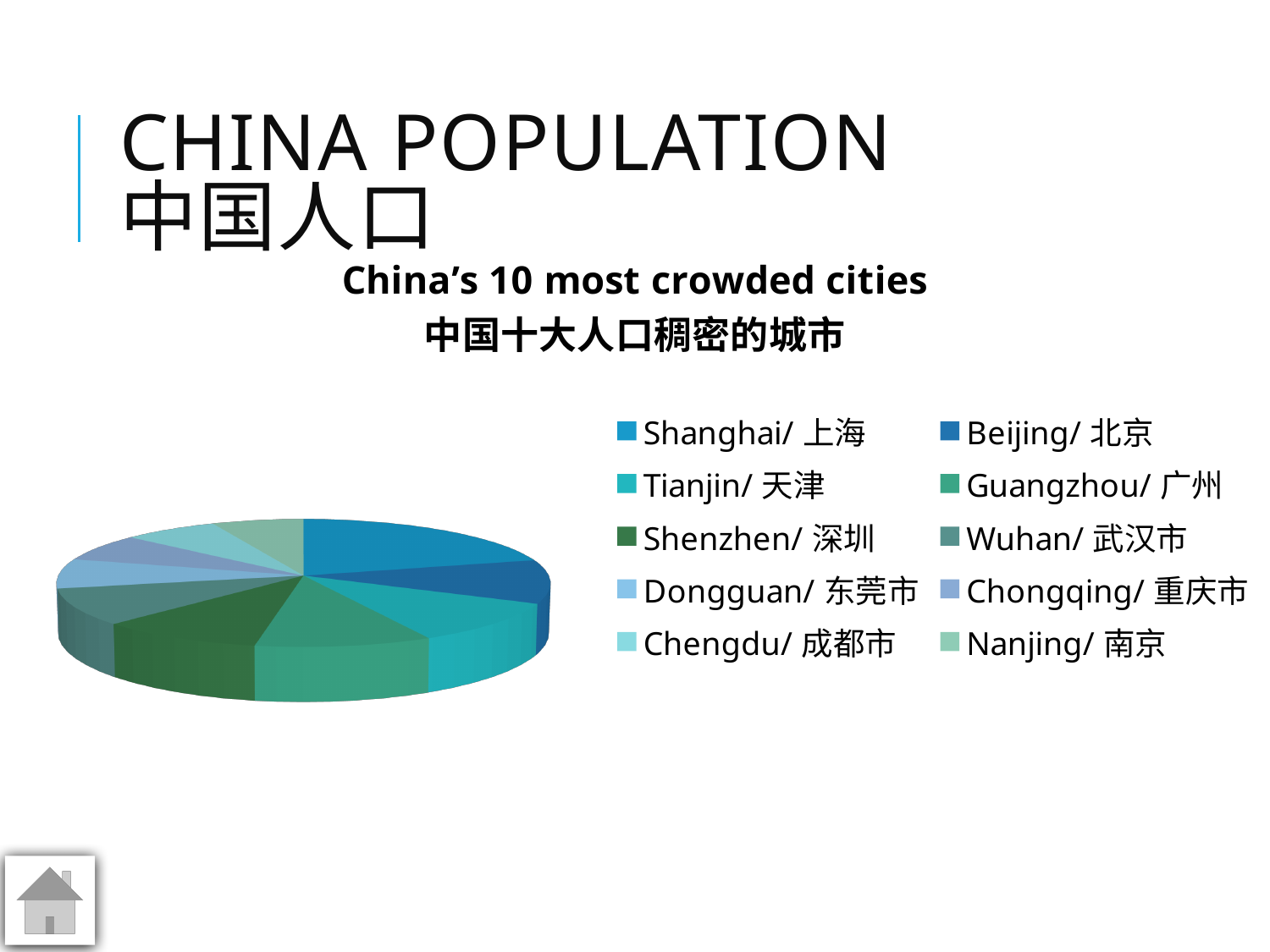
What kind of chart is shown on the slide? pie chart Which city is listed first in the chart legend? Shanghai/ 上海 How many entries does the chart legend list? 10 Which city has the largest slice in the pie chart? Shanghai/ 上海 Which slice is larger, Shanghai or Beijing? Shanghai What is the title of the chart? China’s 10 most crowded cities 中国十大人口稠密的城市 How many cities (slices) does the pie chart show? 10 Which slice is larger, Shanghai or Nanjing? Shanghai